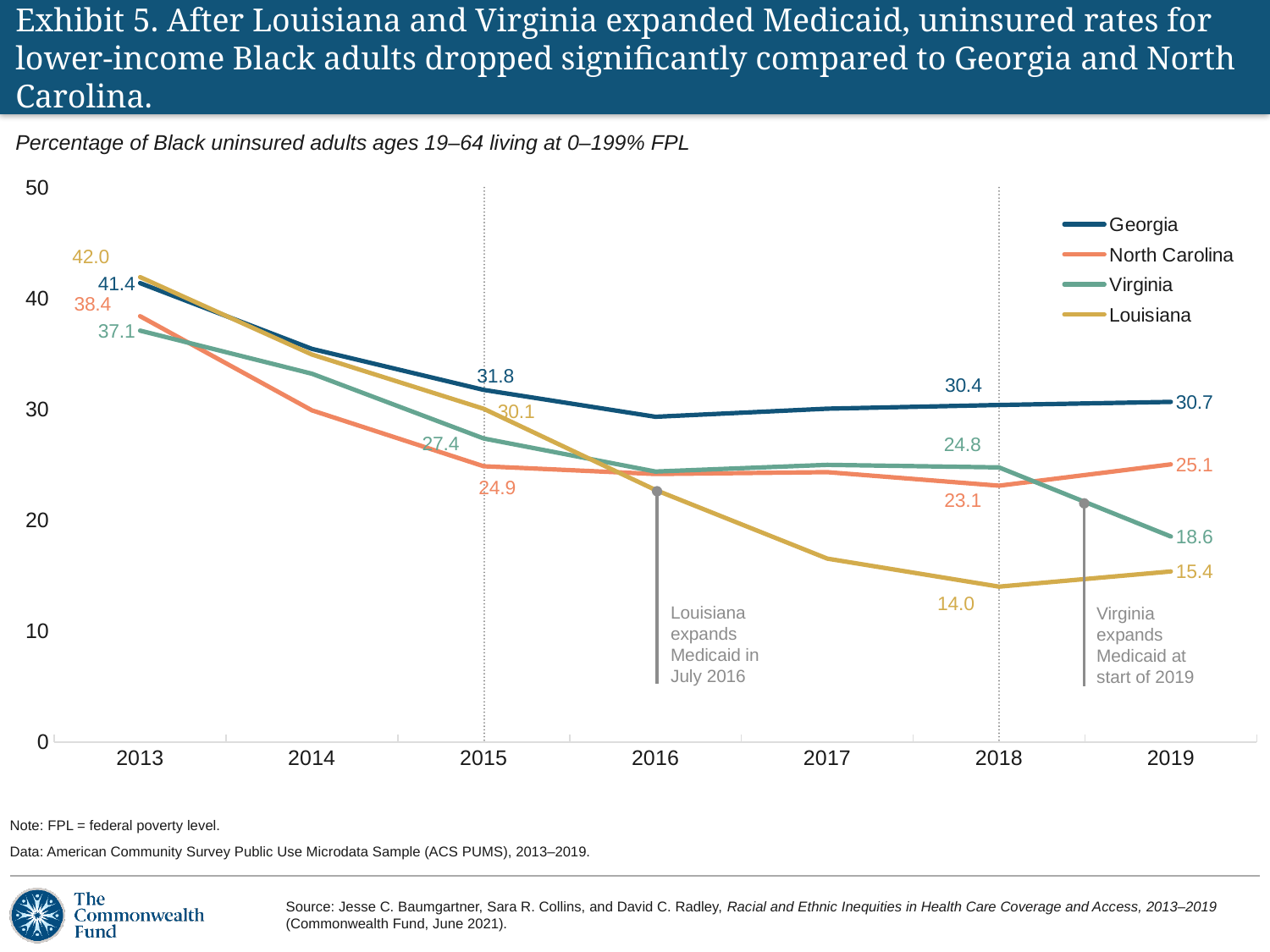
What is the difference between Georgia's and Louisiana's uninsured rates in 2019? 15.3 Which state had the highest uninsured rate in 2019? Georgia What was the uninsured rate for Virginia in 2019? 18.6 How many series does the legend list? 4 What was the uninsured rate for North Carolina in 2015? 24.9 Which state had the lowest uninsured rate in 2018? Louisiana What was the uninsured rate for Louisiana in 2013? 42.0 Did Louisiana's uninsured rate rise or fall from 2013 to 2018? fall What type of chart is shown on the slide? line chart Which was larger in 2015, Georgia's uninsured rate or Virginia's? Georgia Is the value for Louisiana in 2017 greater or less than 20? less How many years are shown on the x axis? 7